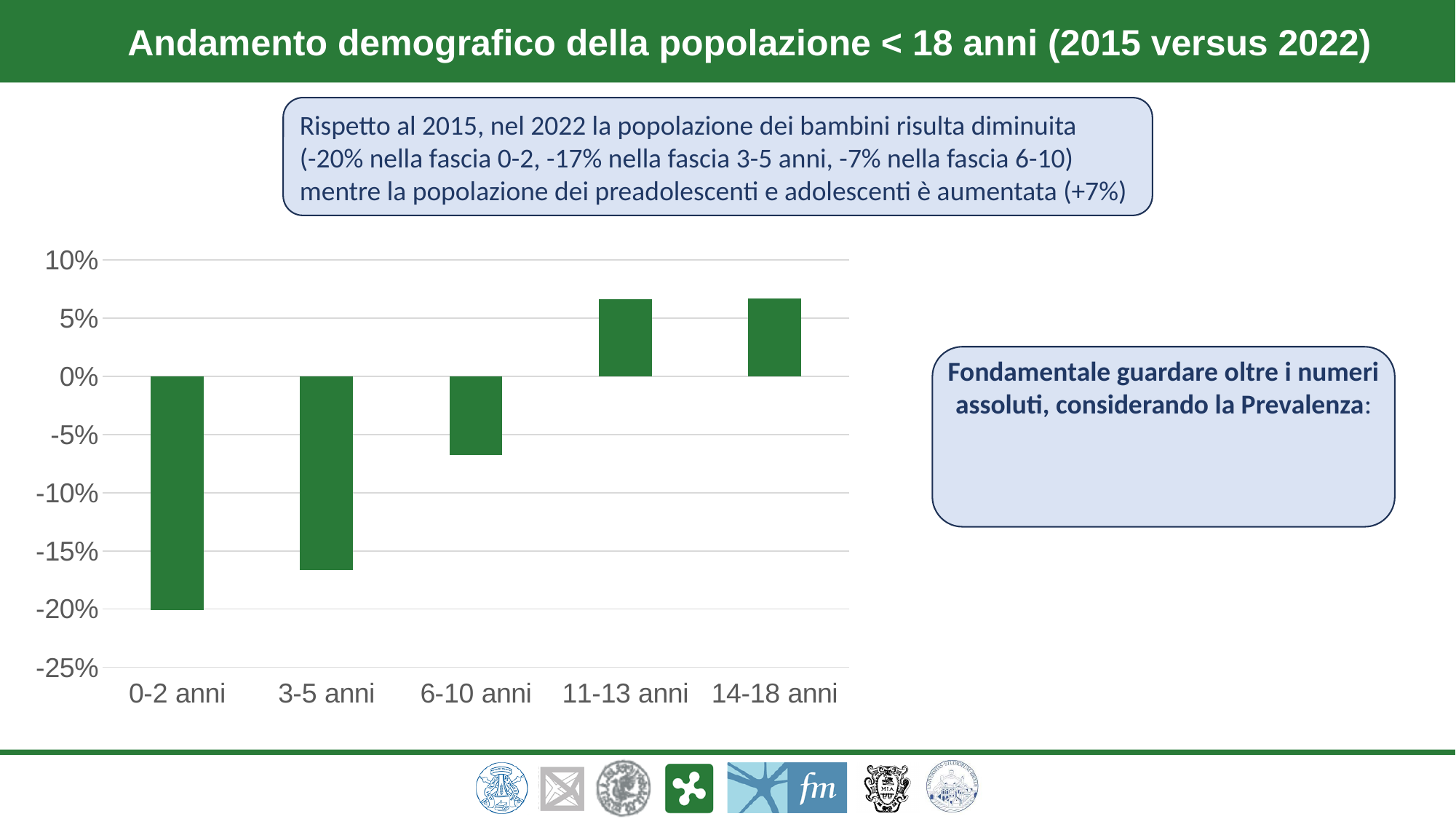
Which has the larger value, 3-5 anni or 6-10 anni? 6-10 anni Is the value for 3-5 anni greater or less than -15%? less What is the value for the 0-2 anni category? -20% Is the value for 6-10 anni greater or less than -5%? less How many age categories are shown on the x axis of the chart? 5 Is the value for 11-13 anni greater or less than 5%? greater What is the title of the slide containing the chart? Andamento demografico della popolazione < 18 anni (2015 versus 2022) Do the values generally rise or fall moving from 0-2 anni to 14-18 anni along the x axis? rise What kind of chart is shown on the slide? bar chart What colour are the bars in the chart? green Which age category has the lowest value in the chart? 0-2 anni